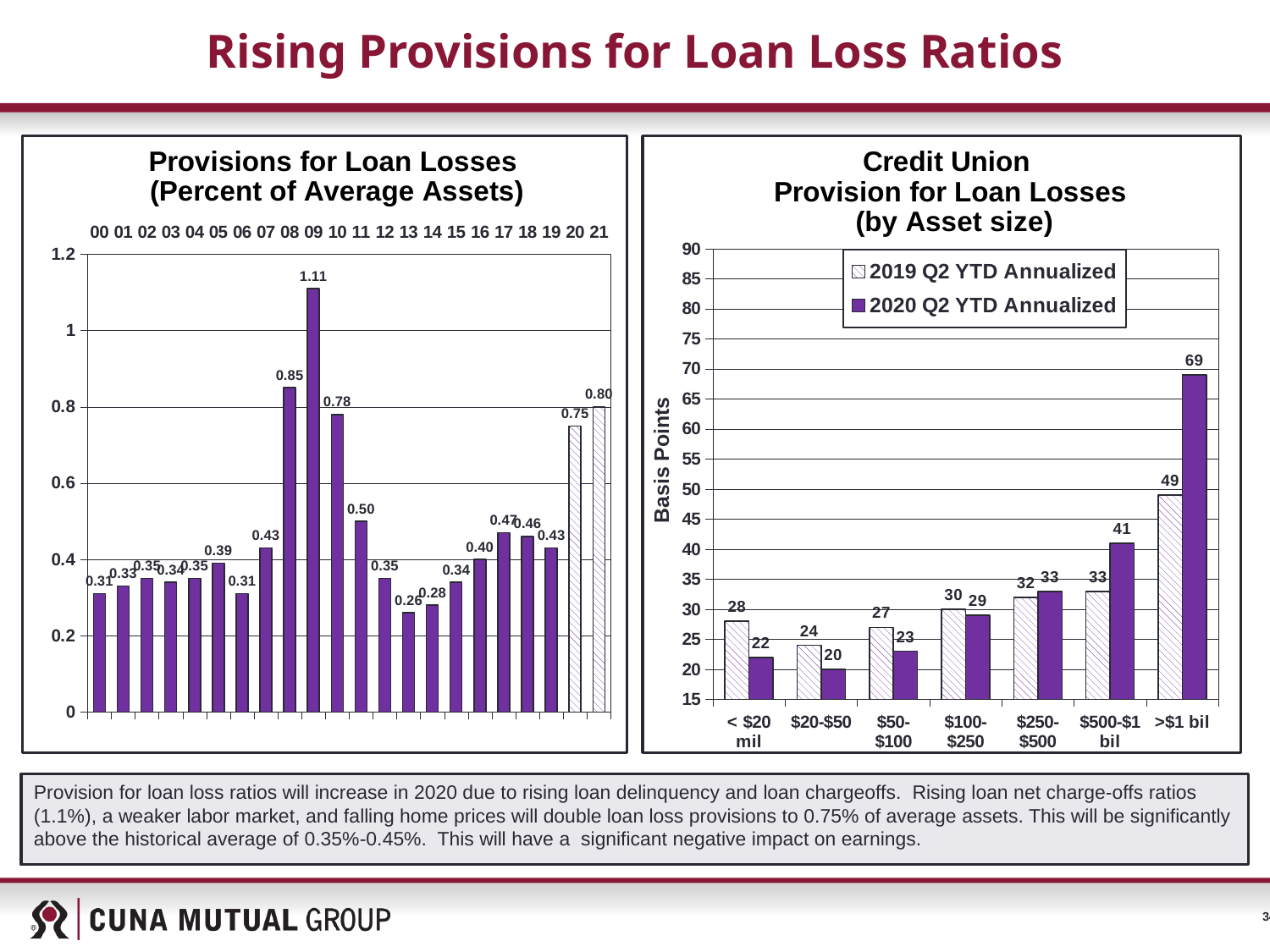
In the 'Provisions for Loan Losses (Percent of Average Assets)' chart, which year has the lowest value? 13 In the 'Provisions for Loan Losses (Percent of Average Assets)' chart, what is the difference between the values for 21 and 20? 0.05 In the 'Provisions for Loan Losses (Percent of Average Assets)' chart, what is the value for 09? 1.11 In the 'Credit Union Provision for Loan Losses (by Asset size)' chart, how many series does the legend list? 2 In the 'Provisions for Loan Losses (Percent of Average Assets)' chart, how many years are plotted? 22 In the 'Provisions for Loan Losses (Percent of Average Assets)' chart, what is the value for 17? 0.47 In the 'Credit Union Provision for Loan Losses (by Asset size)' chart, what is the 2020 Q2 YTD Annualized value for >$1 bil? 69 In the 'Credit Union Provision for Loan Losses (by Asset size)' chart, which asset size has the lowest 2020 Q2 YTD Annualized value? $20-$50 In the 'Provisions for Loan Losses (Percent of Average Assets)' chart, which is larger, the value for 08 or the value for 10? 08 In the 'Credit Union Provision for Loan Losses (by Asset size)' chart, what is the difference between the 2020 and 2019 Q2 YTD Annualized values for $500-$1 bil? 8 In the 'Credit Union Provision for Loan Losses (by Asset size)' chart, what is the 2019 Q2 YTD Annualized value for $50-$100? 27 What kind of chart is the 'Credit Union Provision for Loan Losses (by Asset size)' chart? Bar chart